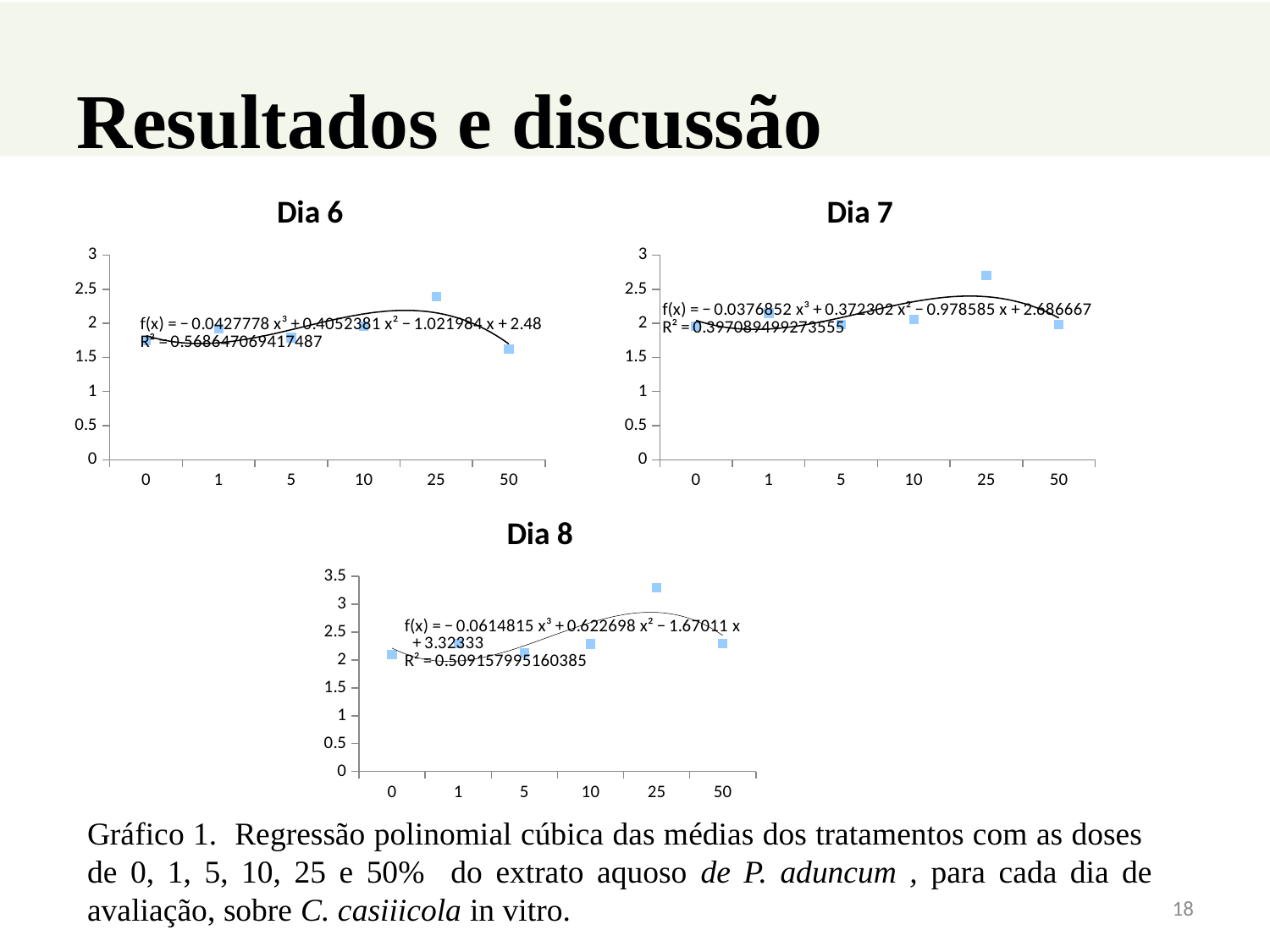
How many data points are plotted in the Dia 8 chart? 6 In the Dia 6 chart, is the value for dose 50 greater or less than 2? less What kind of chart is the Dia 7 chart? scatter chart In the Dia 6 chart, is the value for dose 25 greater or less than 2? greater In the Dia 6 chart, which dose has the highest plotted value? 25 In the Dia 7 chart, is the value for dose 25 greater or less than 2.5? greater In the Dia 7 chart, which dose has the highest plotted value? 25 What R² value is printed on the Dia 6 chart? 0.568647069417487 In the Dia 8 chart, which dose has the highest plotted value? 25 In the Dia 6 chart, which is larger, the value for dose 25 or the value for dose 50? 25